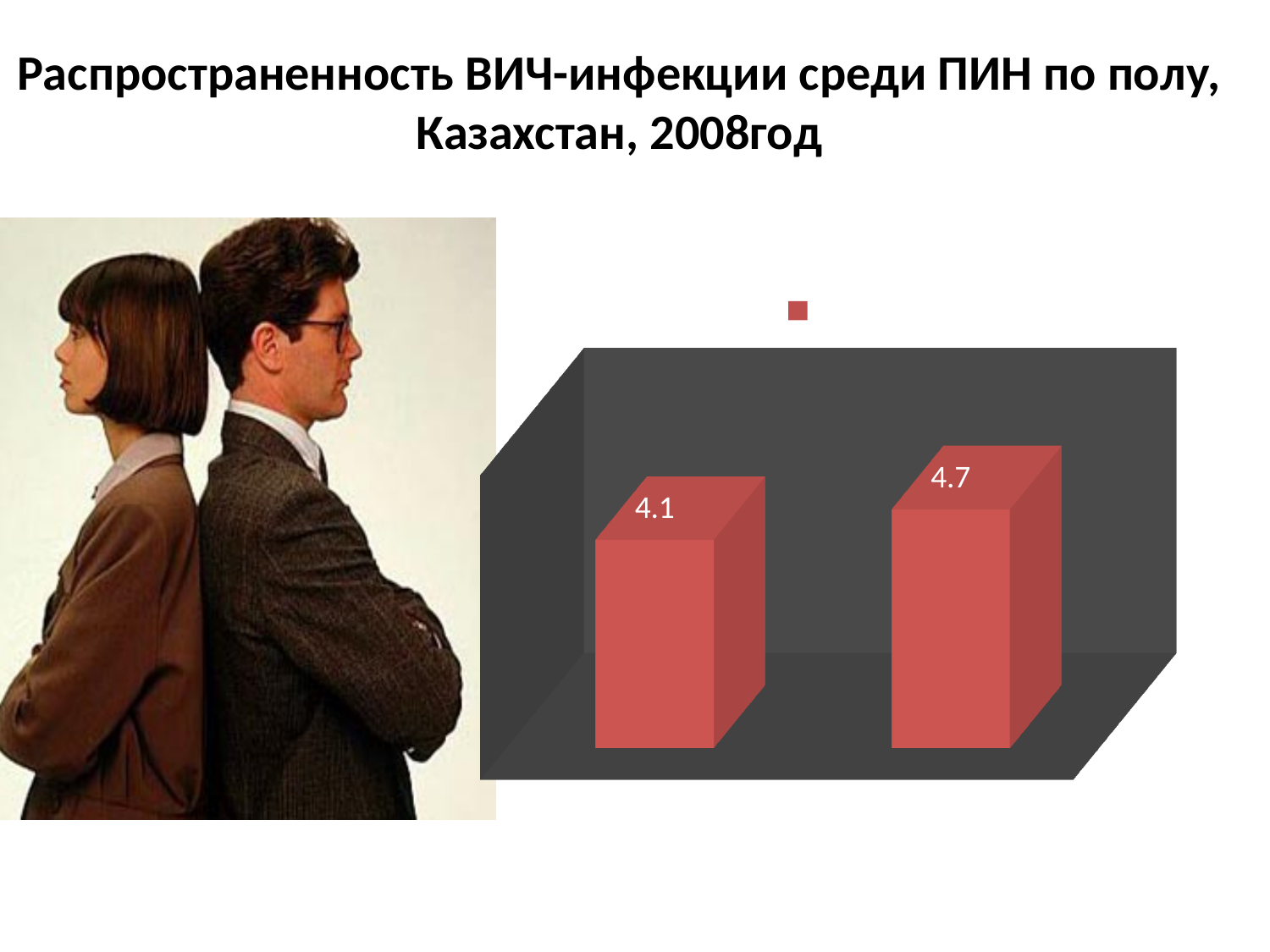
What colour are the bars in the chart? red What is the difference between the values of the right bar and the left bar? 0.6 How many bars are plotted in the chart? 2 What kind of chart is shown on the slide? bar chart What is the value shown on the right bar of the chart? 4.7 Which bar has the lower value, the left or the right one? the left bar What is the value shown on the left bar of the chart? 4.1 What is the title of the slide containing the chart? Распространенность ВИЧ-инфекции среди ПИН по полу, Казахстан, 2008год Which bar has the higher value, the left or the right one? the right bar How many series does the legend list? 1 Is the value of the left bar larger or smaller than the value of the right bar? smaller